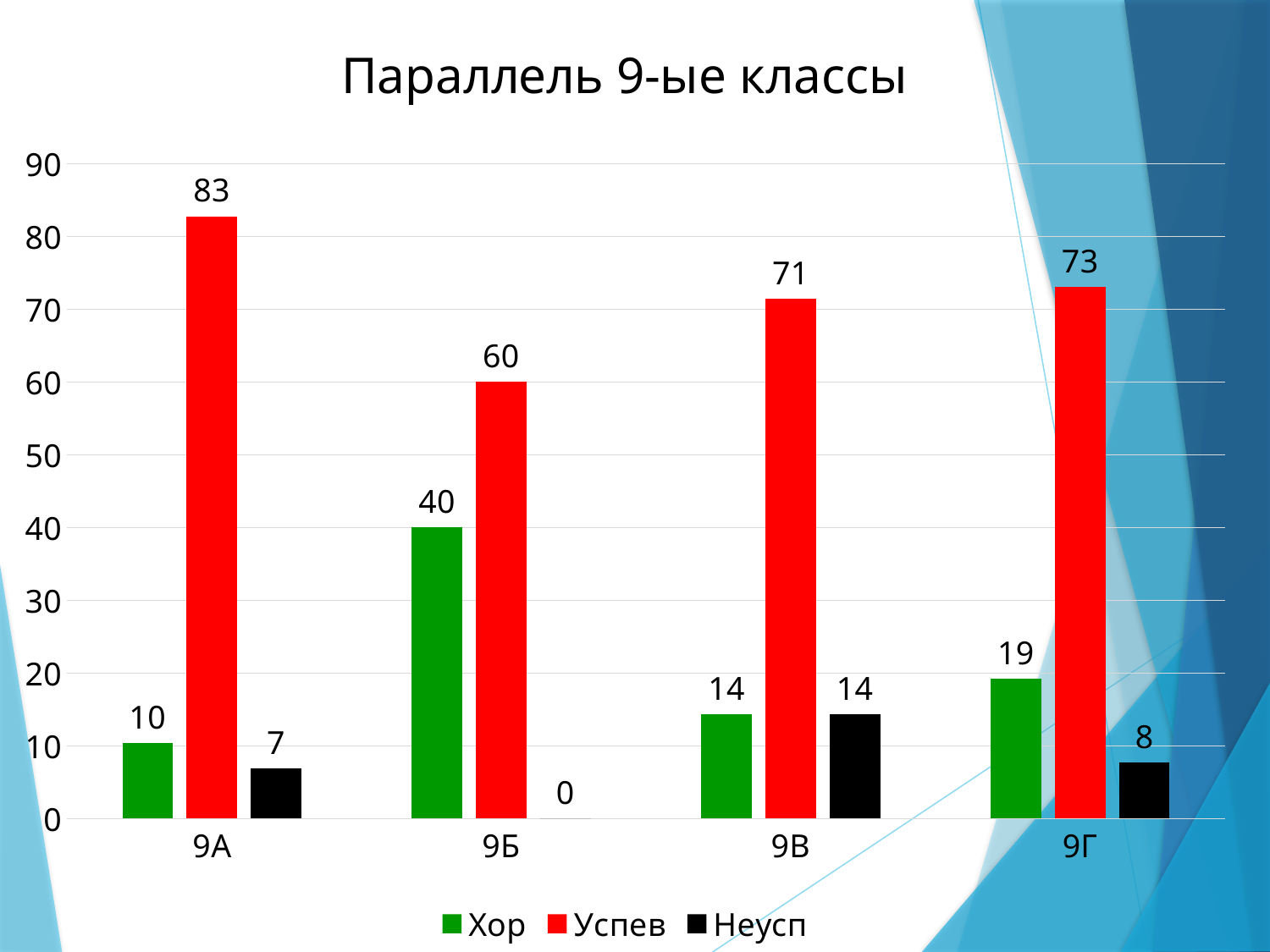
Which class has the lowest Хор value? 9А What is the title of the chart? Параллель 9-ые классы How many classes are shown on the x axis? 4 What is the value of Успев for 9А? 83 Which is larger, the Хор value for 9В or the Хор value for 9Г? 9Г What kind of chart is shown on the slide? bar chart What is the value of Неусп for 9В? 14 What is the difference between the Успев values for 9А and 9Б? 23 What is the value of Хор for 9Б? 40 Which class has the highest Успев value? 9А Is the Успев value for 9Г greater or less than 70? greater How many series does the legend list? 3